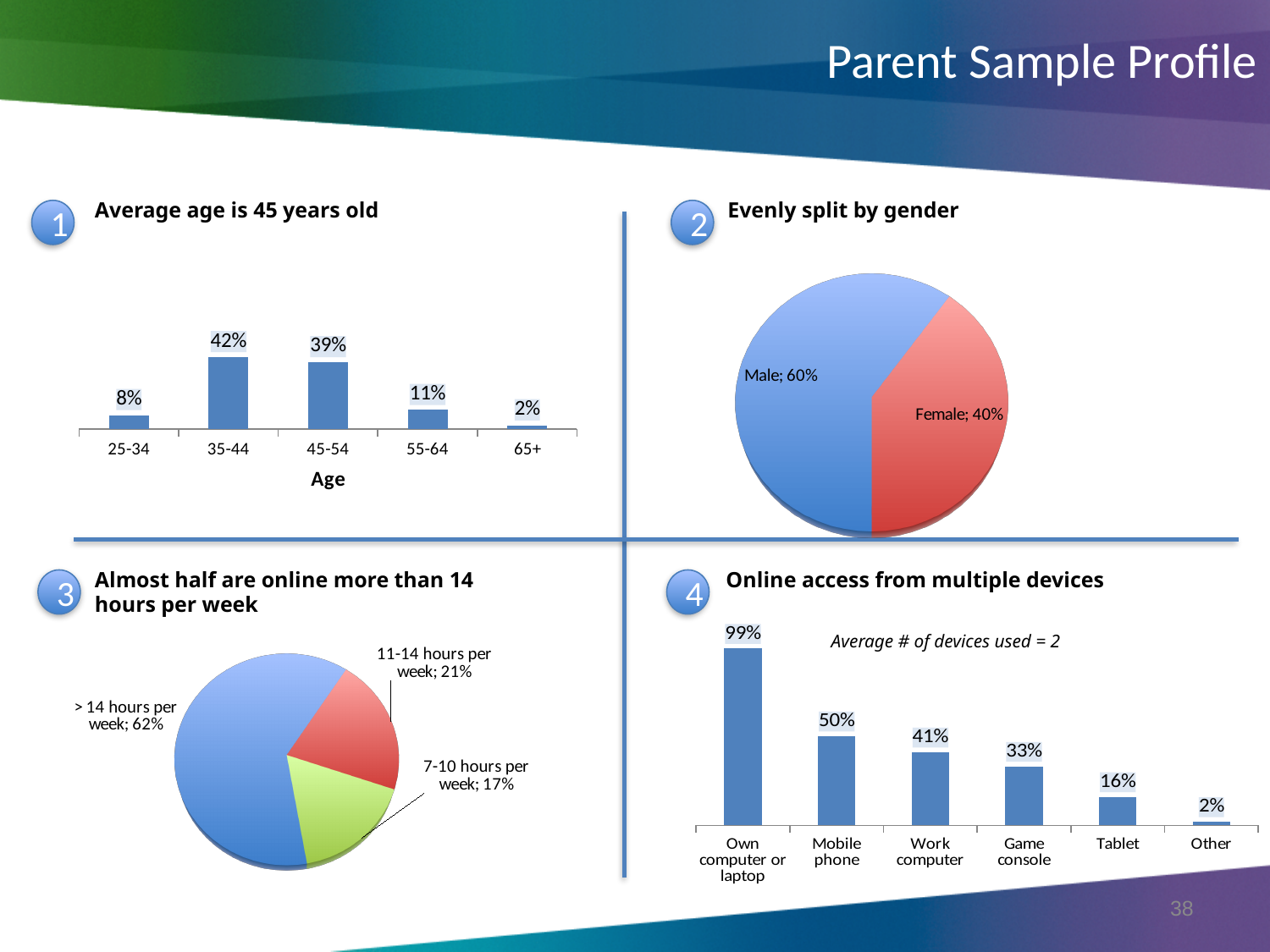
In the hours-online pie chart (bottom left), how many slices are there? 3 In the gender pie chart (top right), which slice is larger, Male or Female? Male In the devices bar chart (bottom right), what is the difference between Work computer and Tablet? 25% In the gender pie chart (top right), what share is Male? 60% In the devices bar chart (bottom right), what percentage use a Mobile phone? 50% In the age bar chart (top left), what percentage of parents are aged 35-44? 42% What type of chart is used for 'Online access from multiple devices' (bottom right)? Bar chart In the devices bar chart (bottom right), which device has the highest percentage? Own computer or laptop In the hours-online pie chart (bottom left), what share is '> 14 hours per week'? 62% In the age bar chart (top left), how many age groups are shown? 5 In the age bar chart (top left), which age group has the lowest percentage? 65+ In the age bar chart (top left), what is the difference between the 35-44 and 45-54 groups? 3%